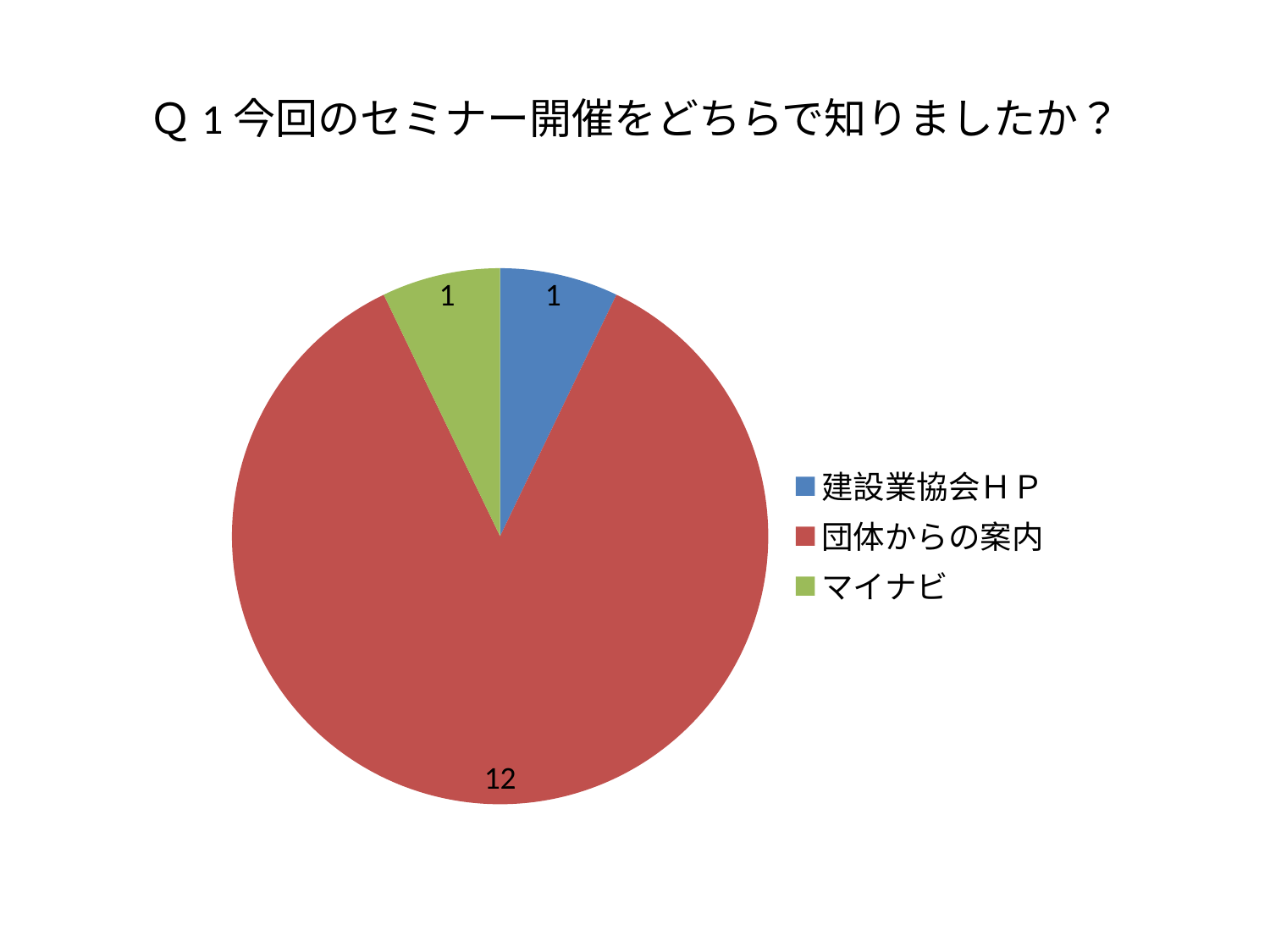
What is the difference between the values for 団体からの案内 and マイナビ? 11 What is the title of the chart? Ｑ１今回のセミナー開催をどちらで知りましたか？ What colour is the slice for マイナビ? green How many categories does the pie chart show? 3 Which category has the largest slice? 団体からの案内 What share of the pie does 団体からの案内 represent? 12 of 14 What is the total of all slices in the pie chart? 14 What is the value for 団体からの案内? 12 Which is larger, the value for 団体からの案内 or the value for 建設業協会ＨＰ? 団体からの案内 What is the value for 建設業協会ＨＰ? 1 What kind of chart is shown on the slide? pie chart What is the value for マイナビ? 1